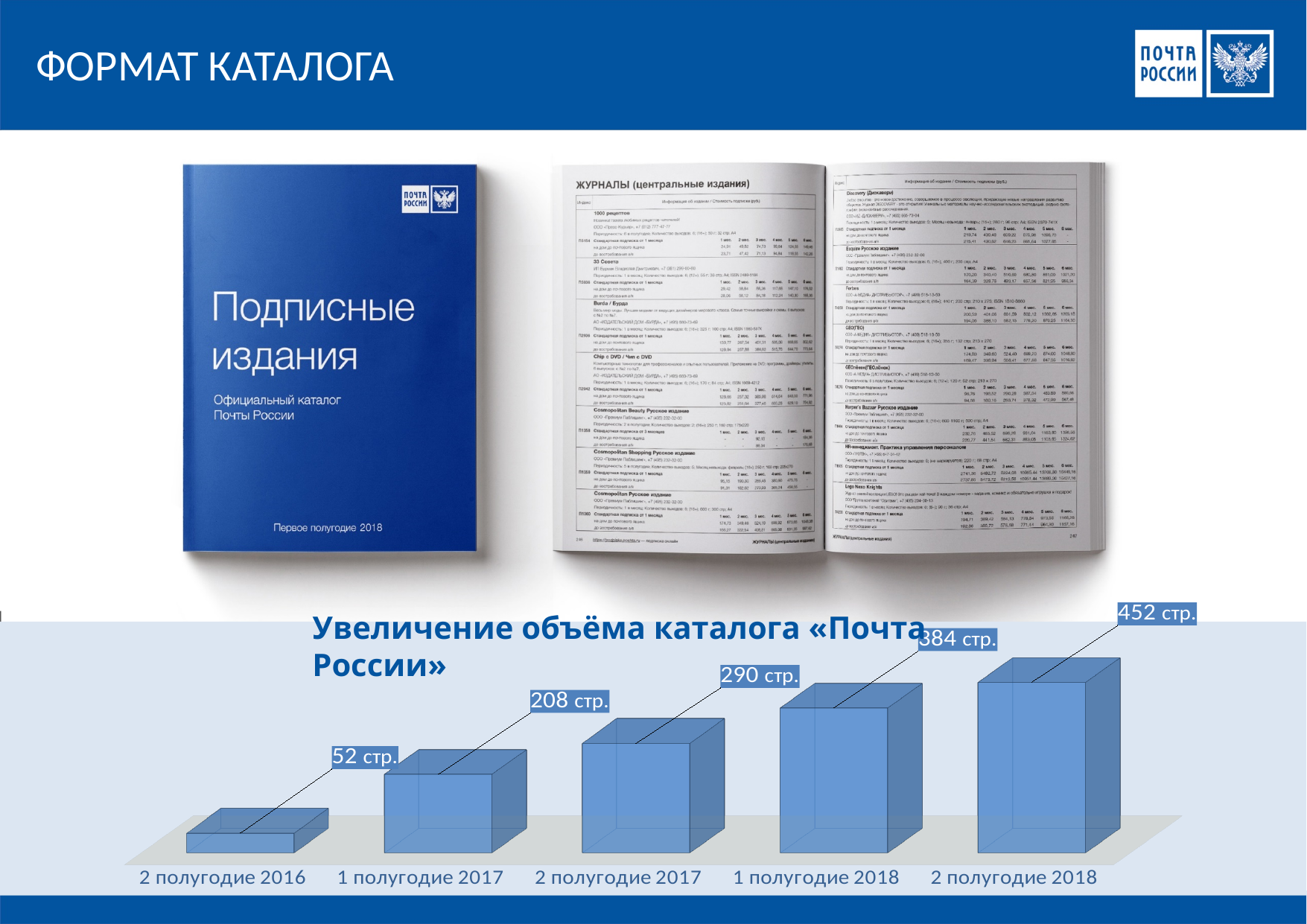
What is the value for 2 полугодие 2018? 452 стр. Which period has the lowest value? 2 полугодие 2016 What kind of chart is shown on the slide? Bar chart What is the value for 1 полугодие 2018? 384 стр. Which period has the highest value? 2 полугодие 2018 What is the value for 1 полугодие 2017? 208 стр. Which is larger, the value for 1 полугодие 2017 or 2 полугодие 2017? 2 полугодие 2017 What is the difference between the values for 2 полугодие 2018 and 2 полугодие 2016? 400 стр. What is the value for 2 полугодие 2017? 290 стр. How many periods are shown in the chart? 5 What is the difference between the values for 1 полугодие 2018 and 2 полугодие 2017? 94 стр. What is the value for 2 полугодие 2016? 52 стр.